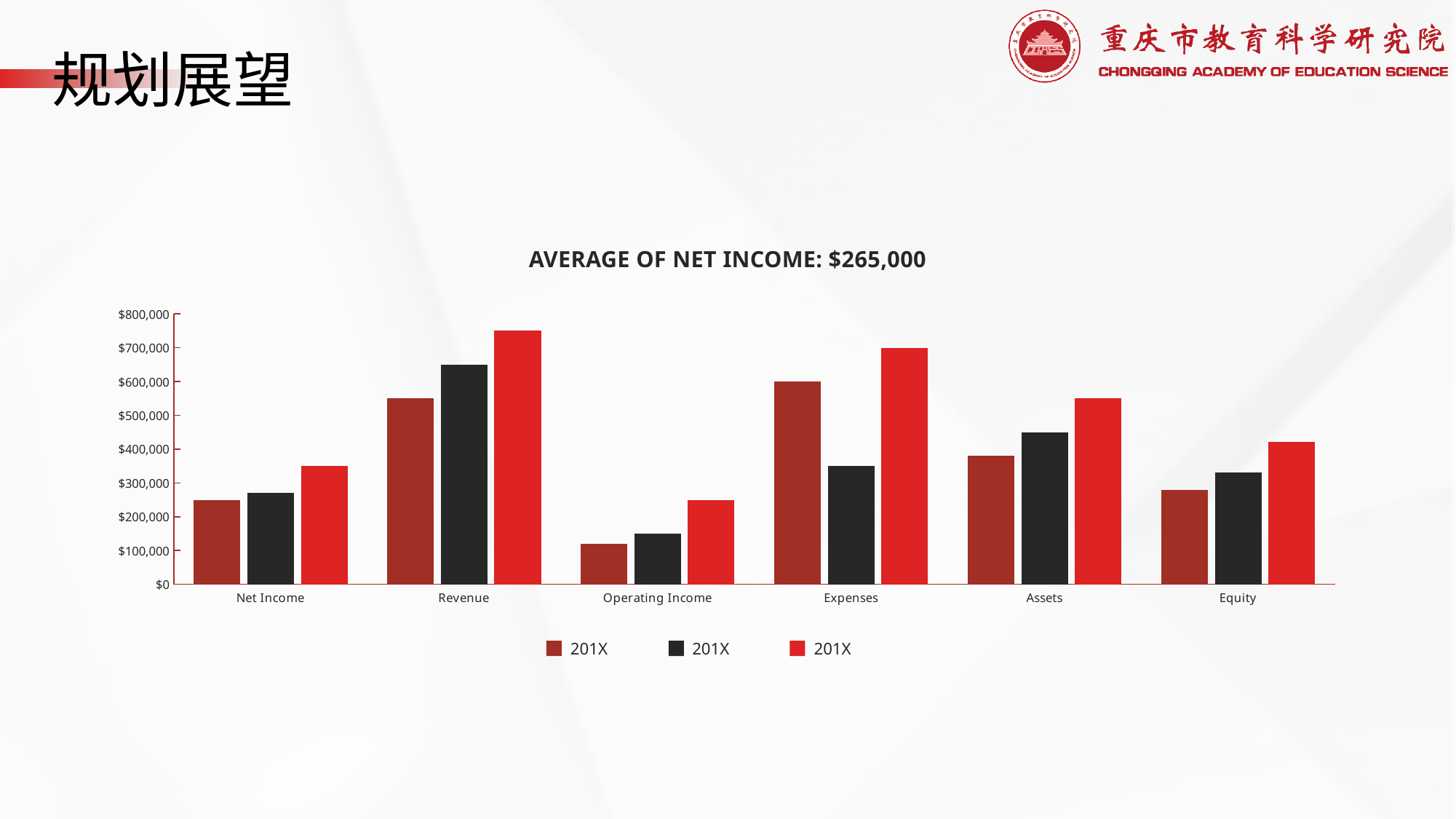
What kind of chart is shown on the slide? bar chart How many series does the chart's legend list? 3 What label is used for all three series in the legend? 201X Is the value of the black bar for Net Income greater or less than $300,000? less How many categories are shown along the x axis of the chart? 6 Which category has the lowest bars in the chart? Operating Income Is the value of the bright red bar for Assets greater or less than $500,000? greater What is the title of the chart? AVERAGE OF NET INCOME: $265,000 Is the value of the bright red bar for Revenue greater or less than $700,000? greater Which category contains the tallest bar in the chart? Revenue Which is larger: the dark red bar for Expenses or the dark red bar for Assets? Expenses